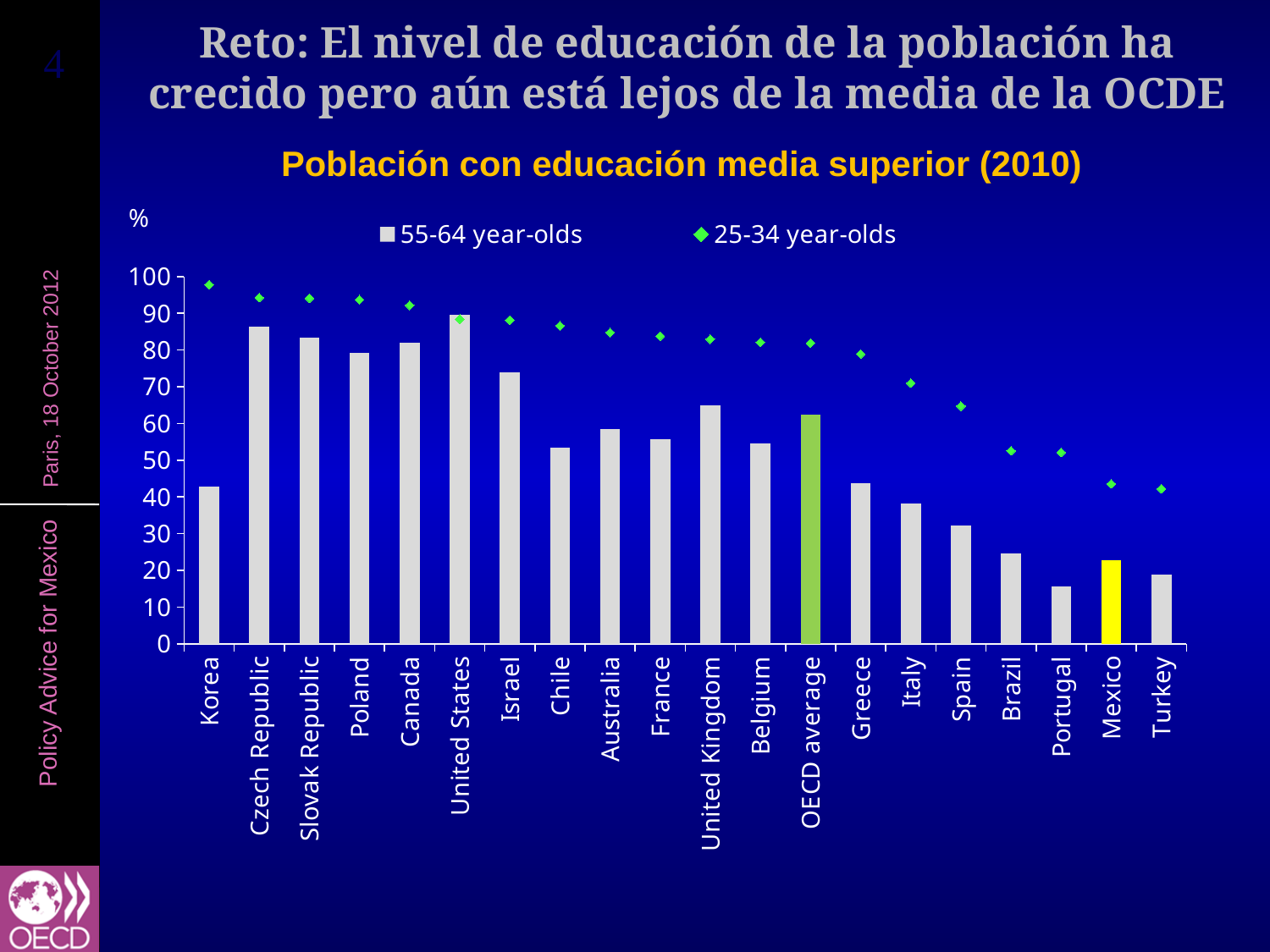
Is the value for 55-64 year-olds in Brazil greater or less than 30? less Is the value for 25-34 year-olds in Turkey greater or less than 50? less How many countries/categories are shown on the x axis? 20 Which category has the highest value for 25-34 year-olds? Korea Which country's bar is highlighted in yellow? Mexico Is the value for 55-64 year-olds in Mexico greater or less than 30? less For Korea, which is larger: the value for 25-34 year-olds or for 55-64 year-olds? 25-34 year-olds How many series does the legend list? 2 Do the values for 25-34 year-olds generally rise or fall from left to right along the x axis? fall What kind of chart is shown on the slide? bar chart (with a diamond marker series)